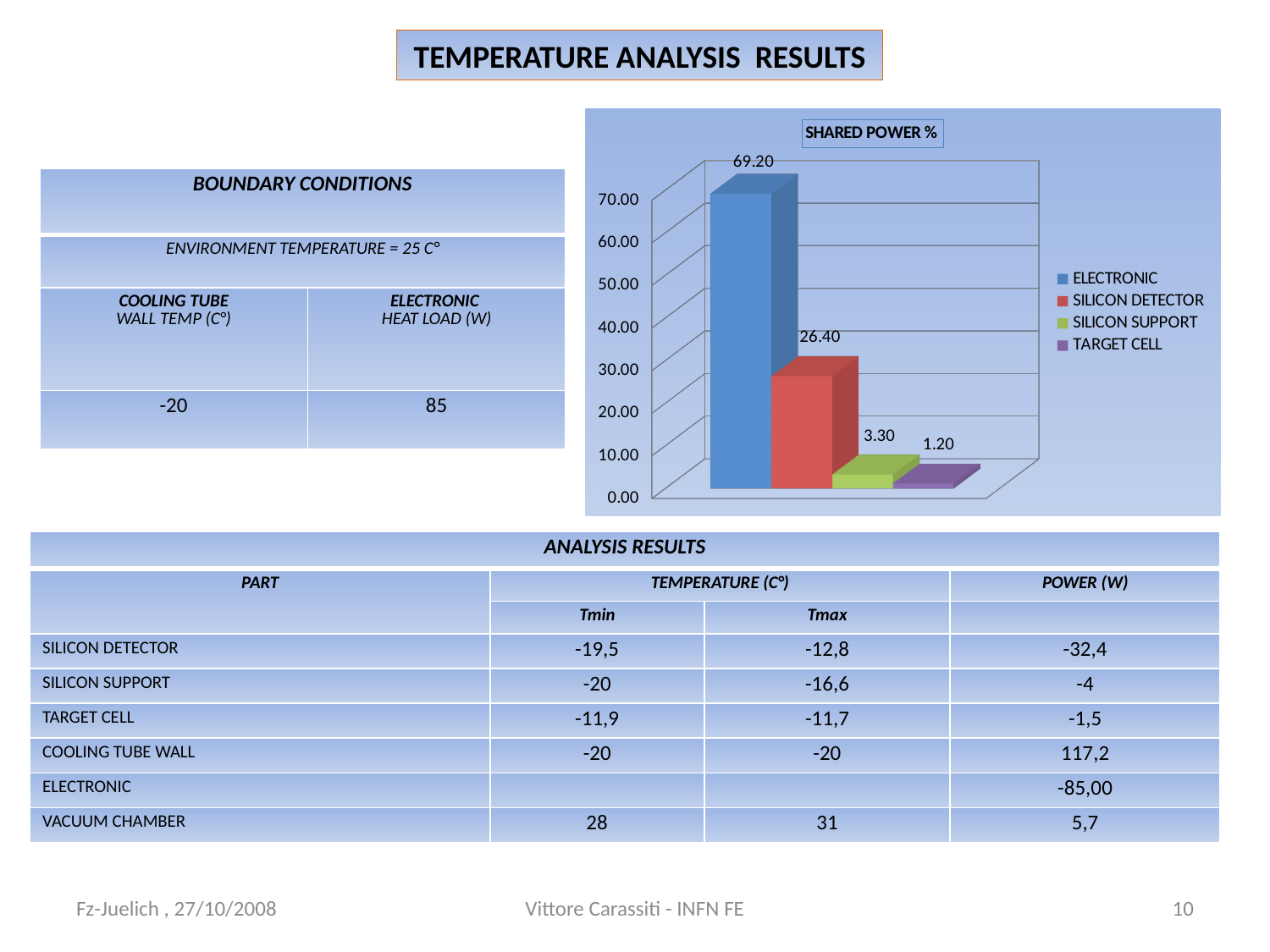
Is the value for SILICON DETECTOR in the SHARED POWER % chart greater or less than 30.00? less What is the value for TARGET CELL in the SHARED POWER % chart? 1.20 What is the value for ELECTRONIC in the SHARED POWER % chart? 69.20 What is the difference between the ELECTRONIC and SILICON DETECTOR values in the SHARED POWER % chart? 42.80 Which is larger in the SHARED POWER % chart, SILICON SUPPORT or TARGET CELL? SILICON SUPPORT What is the title of the chart on the slide? SHARED POWER % Which series has the lowest value in the SHARED POWER % chart? TARGET CELL How many series does the legend of the SHARED POWER % chart list? 4 Which series has the highest value in the SHARED POWER % chart? ELECTRONIC What kind of chart is the SHARED POWER % chart? bar chart What is the value for SILICON DETECTOR in the SHARED POWER % chart? 26.40 What is the value for SILICON SUPPORT in the SHARED POWER % chart? 3.30